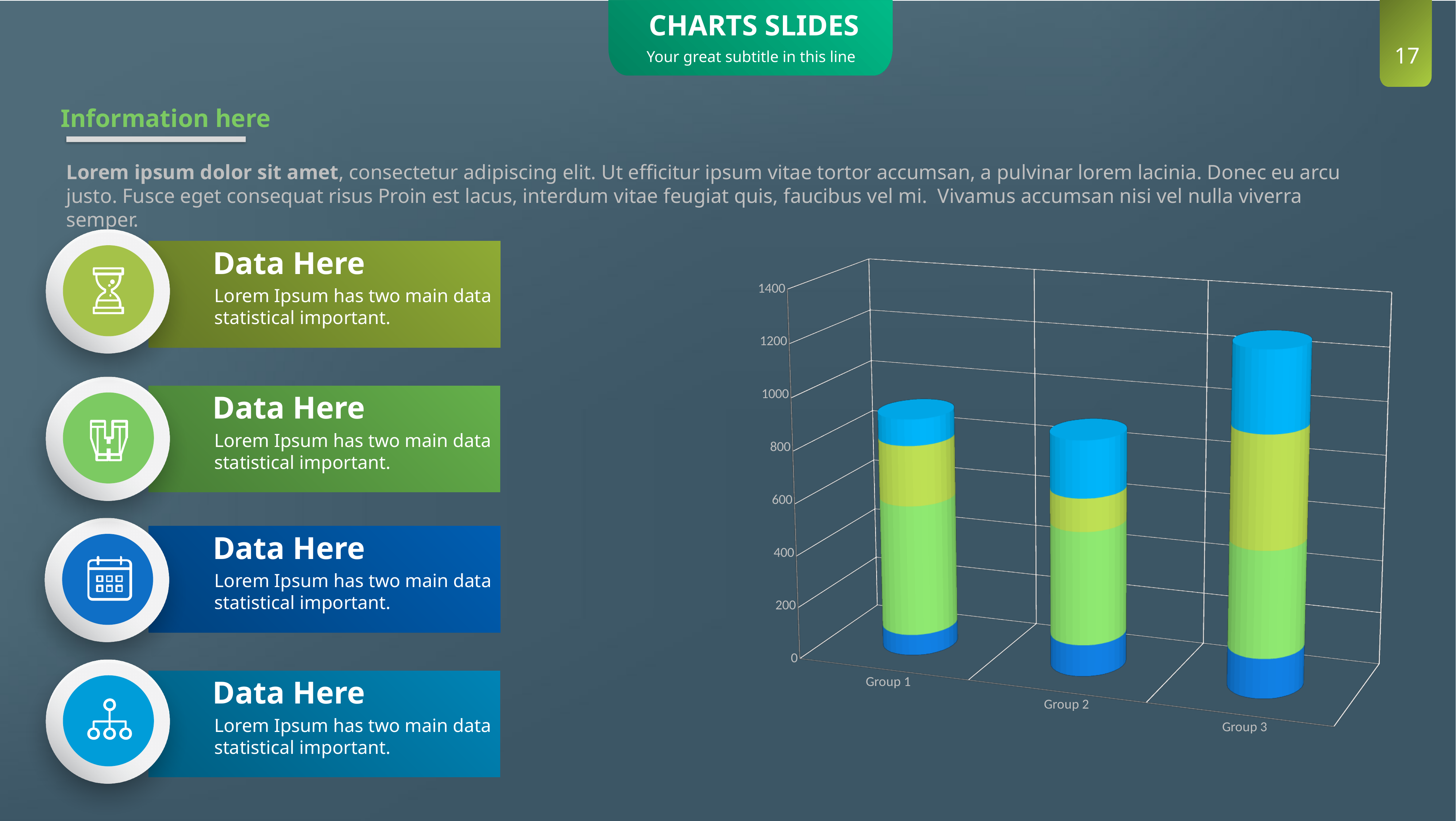
Which is larger, the stacked bar for Group 3 or the stacked bar for Group 1? Group 3 What is the highest value labelled on the chart's vertical axis? 1400 Which group has the tallest stacked bar? Group 3 What kind of chart is shown on the slide? bar chart How many coloured segments make up each stacked bar? 4 How many groups are plotted on the chart's x axis? 3 Is the total value for Group 1 greater or less than 600? greater Is the total value for Group 2 greater or less than 400? greater Is the total value for Group 3 greater or less than 800? greater